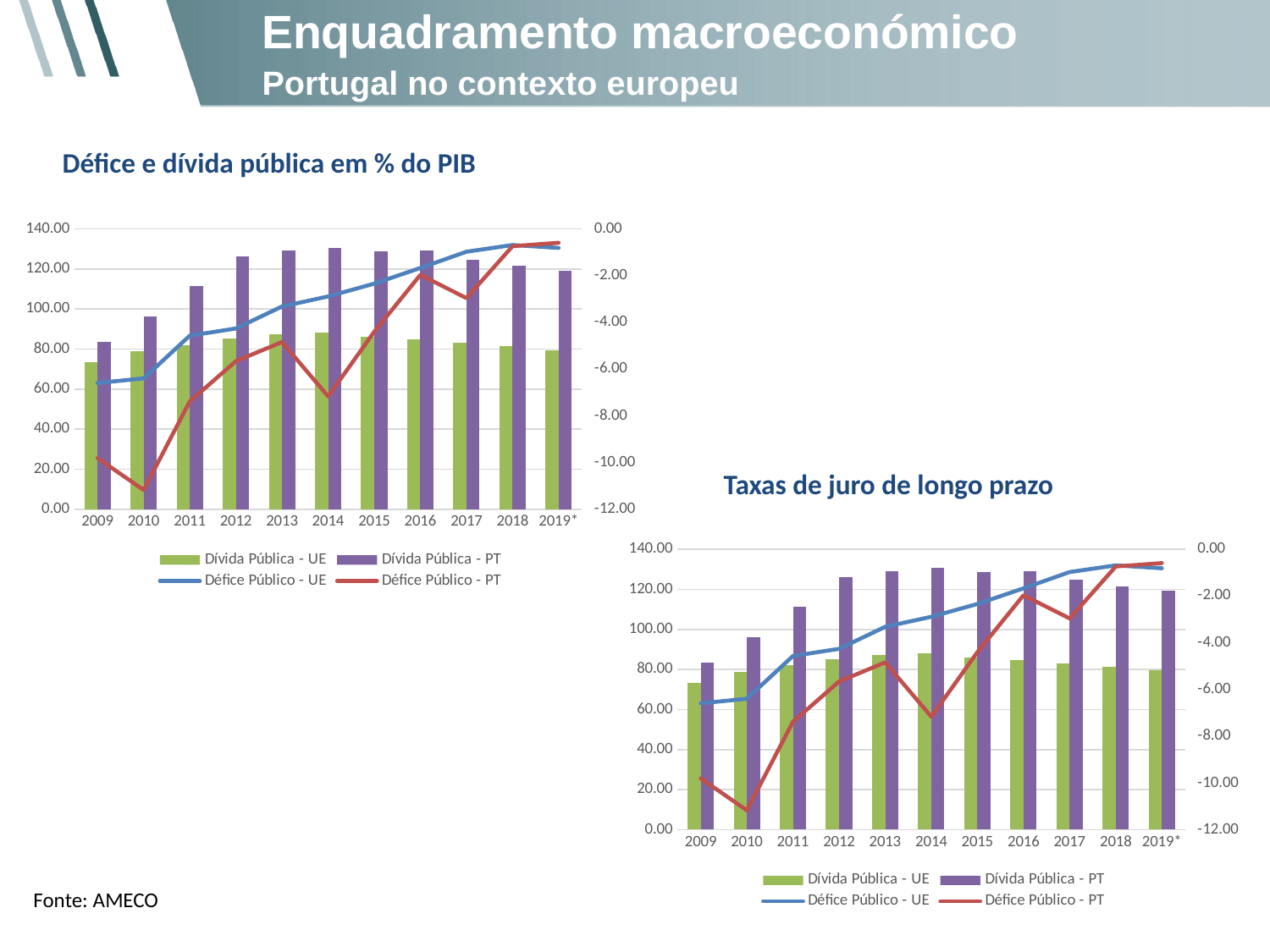
In the chart titled "Défice e dívida pública em % do PIB", in which year is the Dívida Pública - PT bar lowest? 2009 In the chart titled "Défice e dívida pública em % do PIB", how many series does the legend list? 4 In the chart titled "Défice e dívida pública em % do PIB", in which year is the Dívida Pública - UE bar lowest? 2009 In the chart titled "Défice e dívida pública em % do PIB", how many years are shown on the x axis? 11 What kind of chart is the one titled "Taxas de juro de longo prazo"? Combined bar and line chart In the chart titled "Défice e dívida pública em % do PIB", does the Défice Público - UE line generally rise or fall from 2009 to 2019*? rise In the chart titled "Taxas de juro de longo prazo", is the Dívida Pública - UE value for 2009 greater or less than 80.00? less In the chart titled "Taxas de juro de longo prazo", in which year does the Défice Público - PT line reach its lowest point? 2010 In the chart titled "Taxas de juro de longo prazo", which is larger in 2011: Dívida Pública - PT or Dívida Pública - UE? Dívida Pública - PT In the chart titled "Défice e dívida pública em % do PIB", what colour are the Dívida Pública - PT bars? Purple In the chart titled "Défice e dívida pública em % do PIB", is the Dívida Pública - PT value for 2012 greater or less than 120.00? greater In the chart titled "Défice e dívida pública em % do PIB", is the Dívida Pública - PT value for 2010 greater or less than 100.00? less